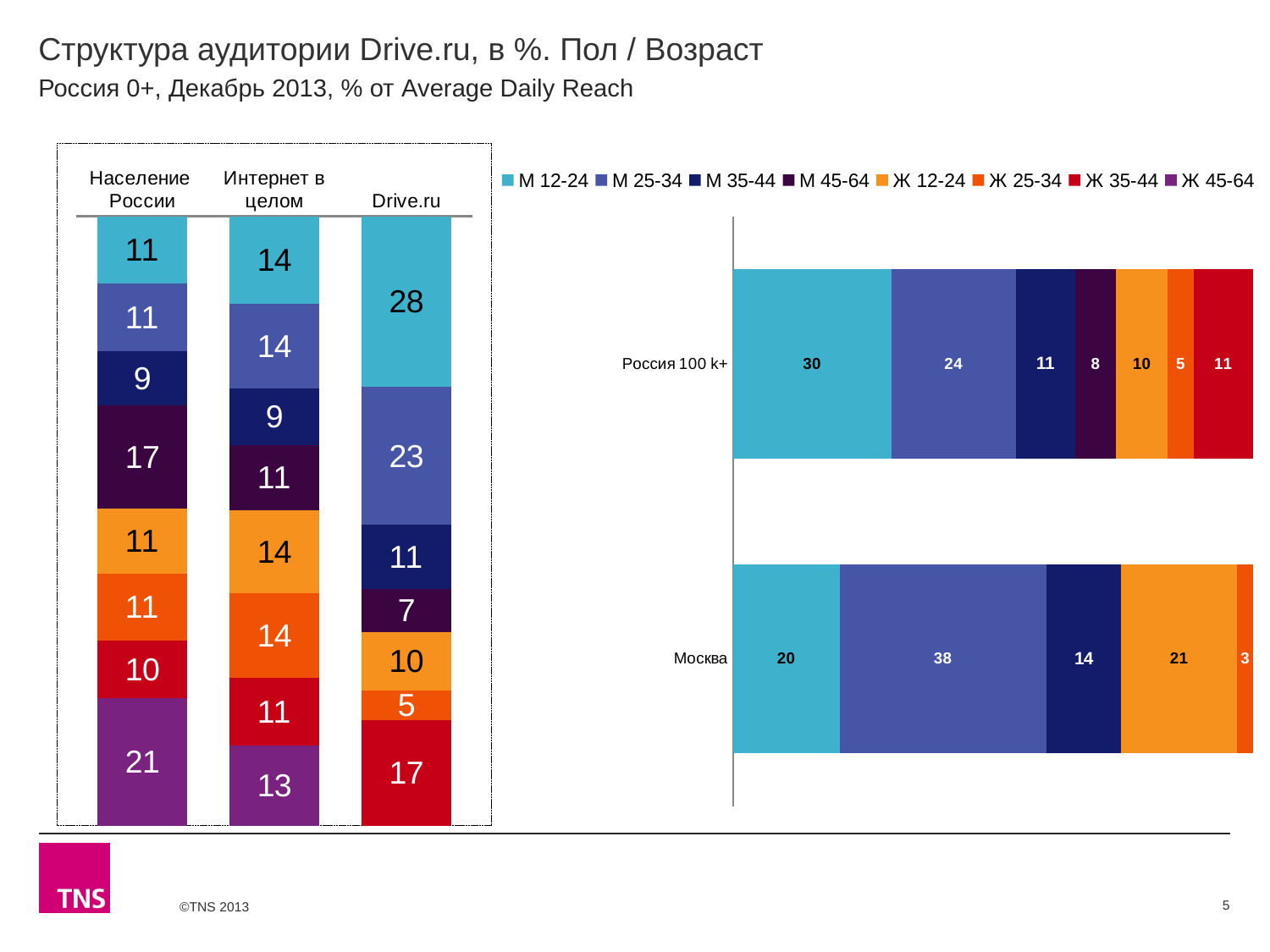
How many series does the legend list? 8 In the right-hand chart, what is the total of the labelled segments of the Россия 100 k+ bar? 99 In the left-hand chart, what is the value of the top (М 12-24) segment of the Drive.ru bar? 28 In the left-hand chart, which is larger: the М 12-24 segment of Drive.ru or the М 12-24 segment of Интернет в целом? Drive.ru What kind of chart is the right-hand chart? Stacked bar chart In the right-hand chart, which segment of the Россия 100 k+ bar is the smallest? Ж 25-34 In the right-hand chart, what is the value of М 12-24 for Россия 100 k+? 30 How many bars are shown in the right-hand chart? 2 In the right-hand chart, what is the difference between the М 25-34 values for Москва and Россия 100 k+? 14 In the right-hand chart, which segment of the Москва bar is the largest? М 25-34 In the left-hand chart, what is the value of the bottom (Ж 45-64) segment of the Население России bar? 21 In the right-hand chart, what is the value of М 25-34 for Москва? 38